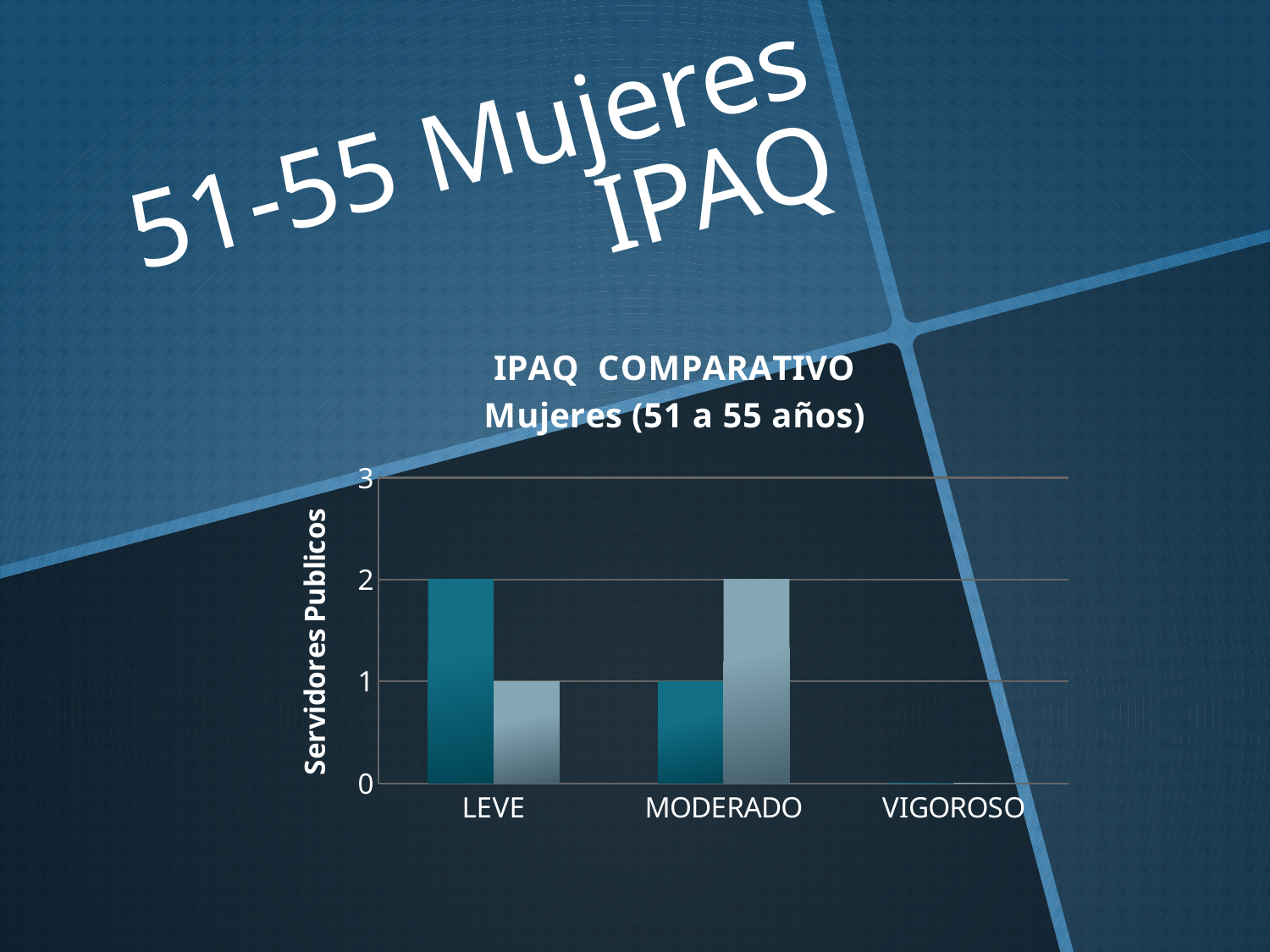
How many categories are shown on the x axis of the chart? 3 What is the value of the light grey-blue bar for LEVE? 1 What kind of chart is shown on the slide? bar chart What is the value of the light grey-blue bar for MODERADO? 2 What is the value of the dark teal bar for LEVE? 2 What is the difference between the dark teal bar and the light grey-blue bar for LEVE? 1 In which category does the light grey-blue series reach its highest value? MODERADO What is the title of the y axis of the chart? Servidores Publicos What is the value of the dark teal bar for MODERADO? 1 For LEVE, which bar is taller, the dark teal bar or the light grey-blue bar? dark teal bar In which category does the dark teal series reach its highest value? LEVE Which category has the lowest values, with no visible bars? VIGOROSO